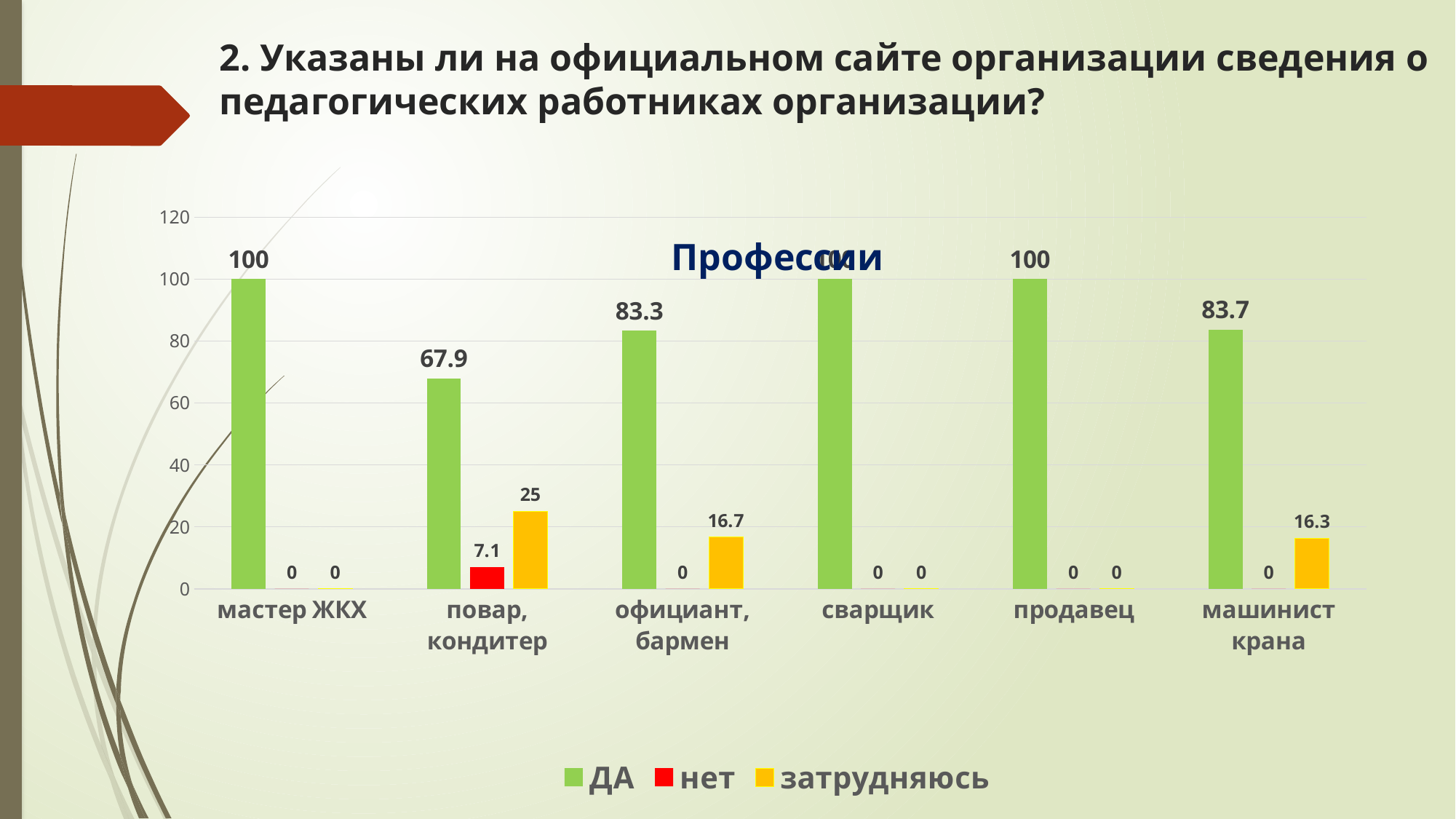
What is the value of ДА for машинист крана? 83.7 What is the title of the chart? Профессии What type of chart is shown on the slide? bar chart How many series does the legend list? 3 Which profession has the highest затрудняюсь value? повар, кондитер Is the ДА value for официант, бармен larger or smaller than the ДА value for машинист крана? smaller Which profession has the lowest ДА value? повар, кондитер What is the value of нет for повар, кондитер? 7.1 What is the value of затрудняюсь for официант, бармен? 16.7 What is the value of ДА for повар, кондитер? 67.9 How many professions (categories) are shown on the x axis? 6 What is the difference between the ДА values for мастер ЖКХ and повар, кондитер? 32.1